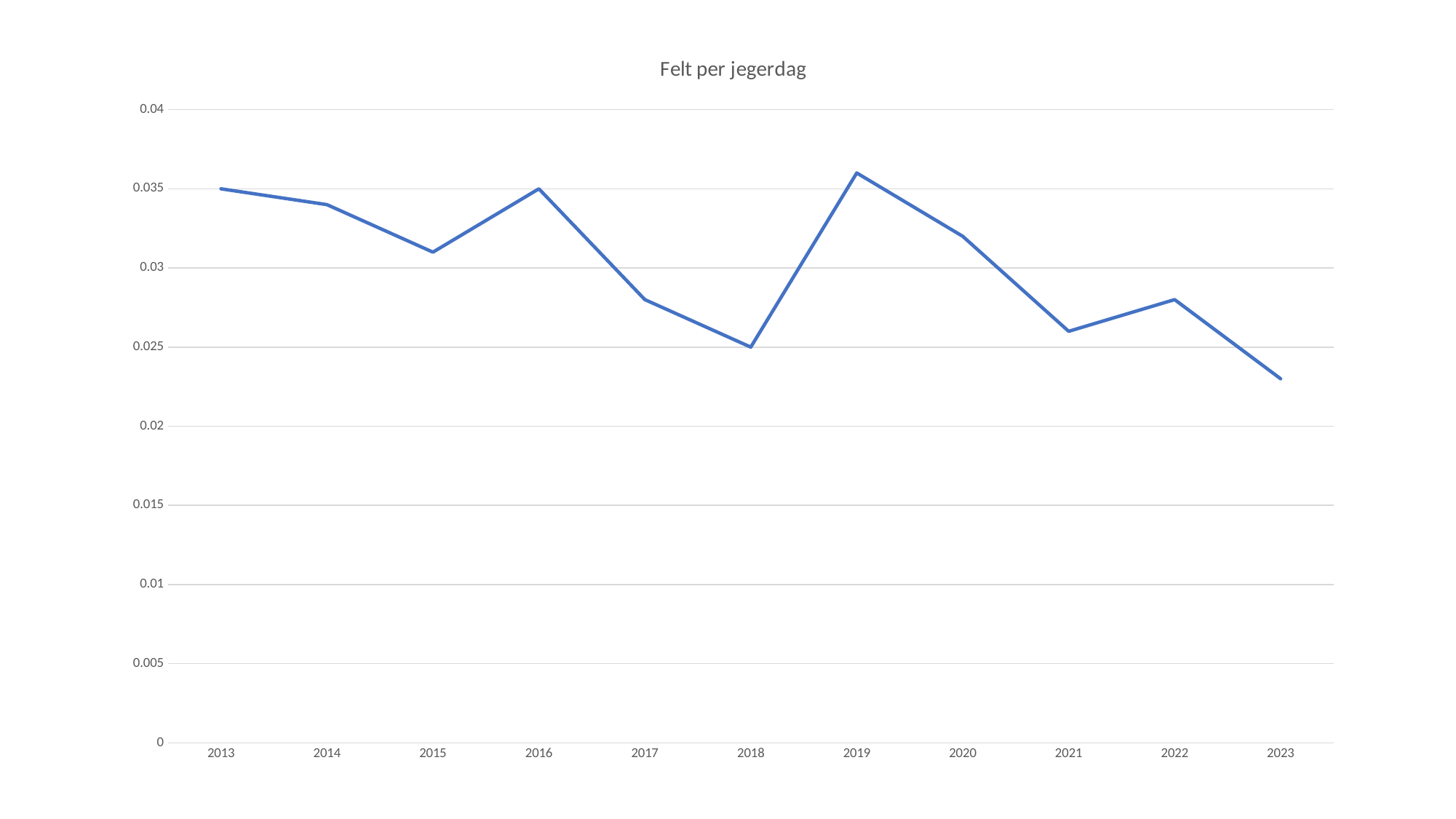
What kind of chart is shown on the slide? Line chart Is the value for 2017 greater or less than 0.03? less Is the value for 2020 greater or less than 0.03? greater Which year has the lowest value? 2023 What is the title of the chart? Felt per jegerdag What is the value for 2013? 0.035 What is the value for 2018? 0.025 Overall, do the values rise or fall from 2013 to 2023? fall Which year has the highest value? 2019 Which is larger, the value for 2015 or the value for 2017? 2015 What is the value for 2016? 0.035 How many years are plotted along the x axis? 11